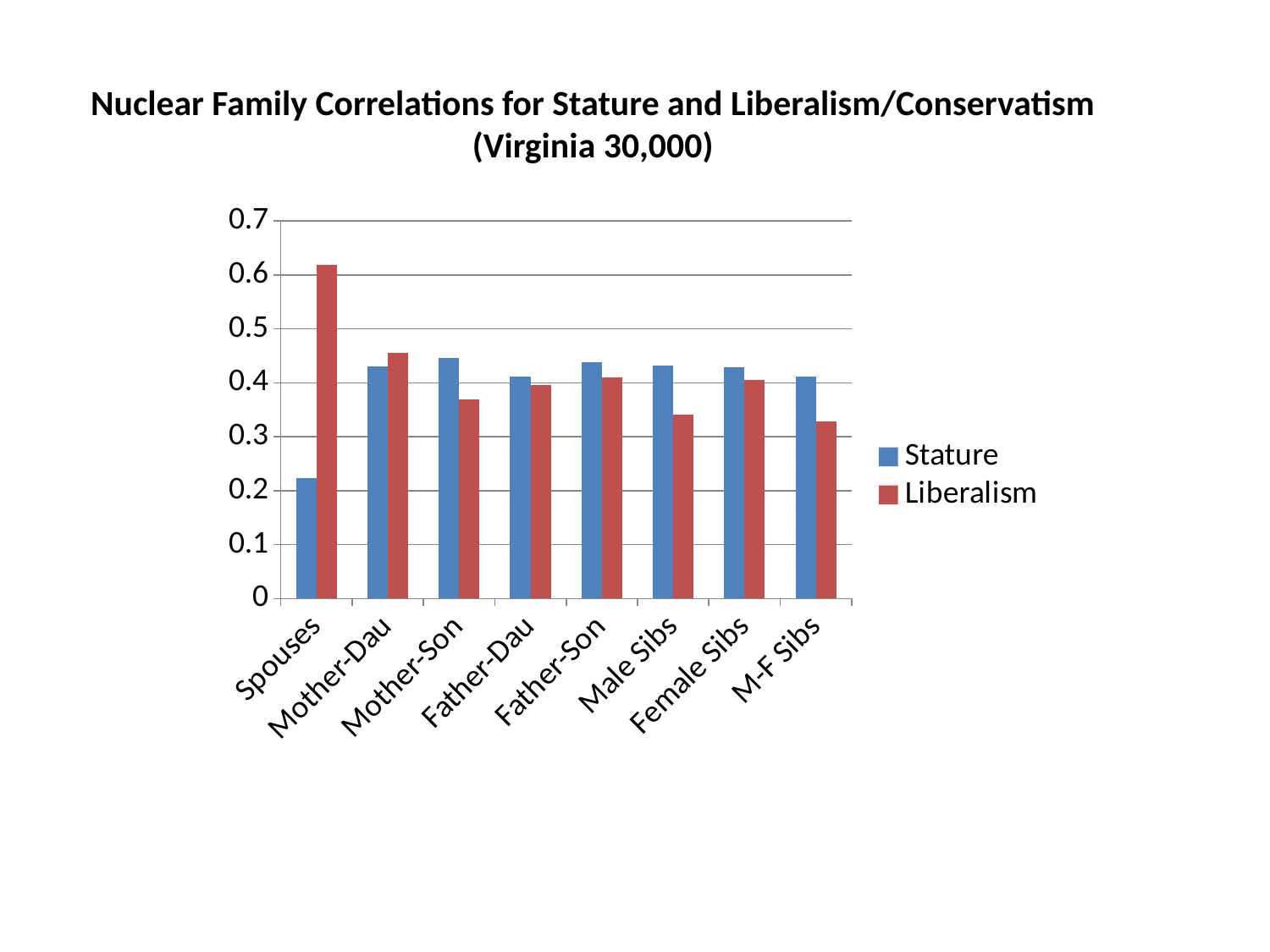
For Spouses, which is larger: the Stature correlation or the Liberalism correlation? Liberalism Which colour represents the Liberalism series in the legend? Red Is the Stature value for Spouses greater or less than 0.3? less Is the Liberalism value for Spouses greater or less than 0.5? greater What kind of chart is shown on the slide? Bar chart Which category has the lowest Stature correlation? Spouses For Mother-Son, which is larger: the Stature correlation or the Liberalism correlation? Stature How many family-pair categories are shown on the x axis? 8 Which category has the highest Liberalism correlation? Spouses How many series does the legend list? 2 Is the Stature value for Mother-Dau greater or less than 0.4? greater